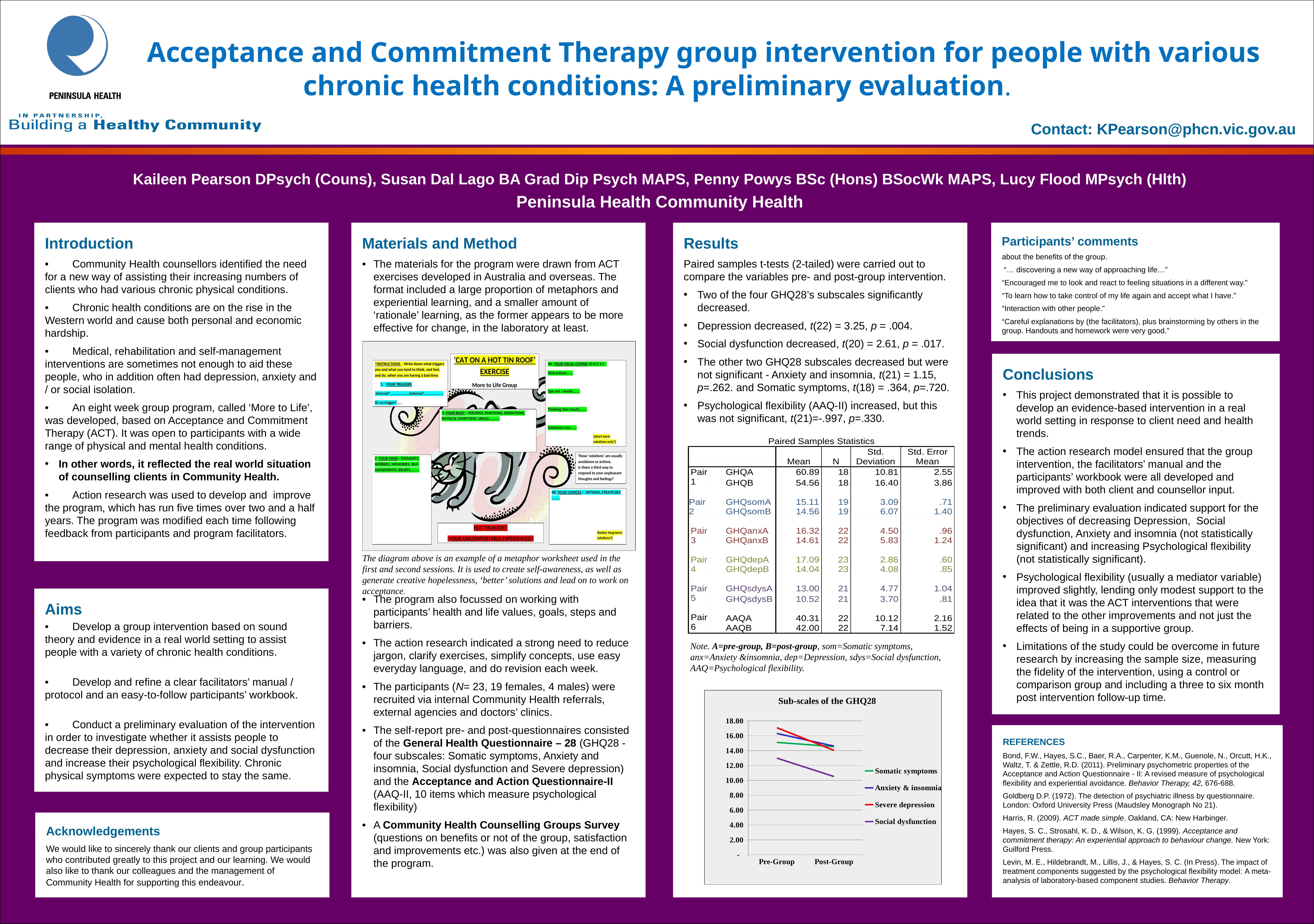
In the "Sub-scales of the GHQ28" chart, does the Severe depression line rise or fall from Pre-Group to Post-Group? fall In the "Sub-scales of the GHQ28" chart, does the Social dysfunction line rise or fall from Pre-Group to Post-Group? fall In the "Sub-scales of the GHQ28" chart, is the Post-Group value for Social dysfunction greater or less than 12.00? less In the "Sub-scales of the GHQ28" chart, which series has the lowest value at Post-Group? Social dysfunction In the "Sub-scales of the GHQ28" chart, which series has the lowest value at Pre-Group? Social dysfunction What kind of chart is shown under the title "Sub-scales of the GHQ28"? line chart In the "Sub-scales of the GHQ28" chart, is the Pre-Group value for Somatic symptoms greater or less than 14.00? greater What colour is the Social dysfunction line in the "Sub-scales of the GHQ28" chart? purple How many series does the legend of the "Sub-scales of the GHQ28" chart list? 4 In the "Sub-scales of the GHQ28" chart, is the Pre-Group value for Severe depression greater or less than 16.00? greater In the "Sub-scales of the GHQ28" chart, which series has the highest value at Pre-Group? Severe depression How many categories are shown on the x axis of the "Sub-scales of the GHQ28" chart? 2